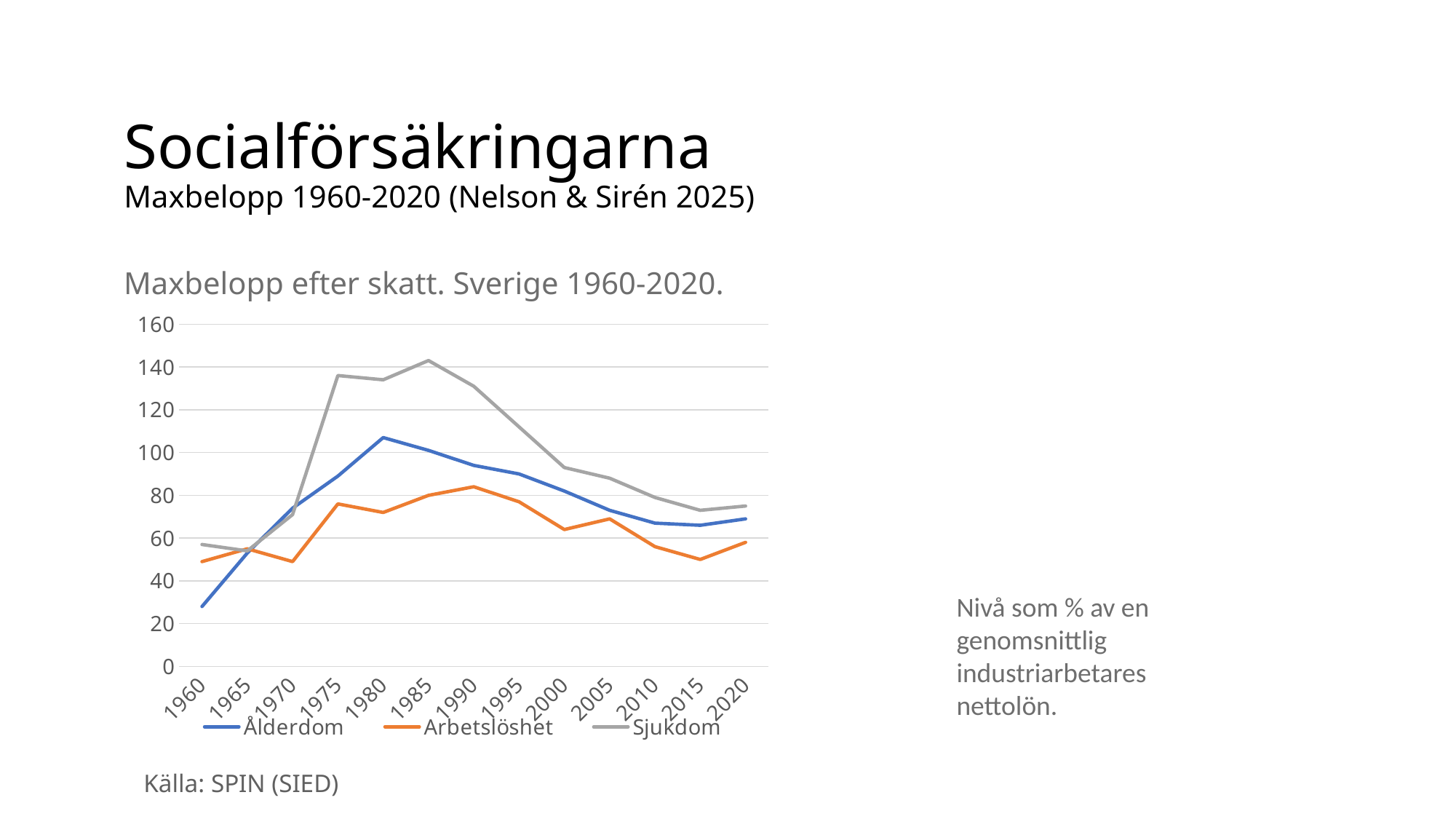
Which series reaches the highest value anywhere on the chart? Sjukdom How many years are marked along the x axis? 13 How many series does the legend list? 3 Does the Sjukdom line rise or fall between 1985 and 2015? fall Is the value for Sjukdom in 1985 greater or less than 120? greater What kind of chart is shown on the slide? line chart Is the value for Ålderdom in 1960 greater or less than 40? less In which year does the Ålderdom line reach its peak? 1980 In which year does the Sjukdom line reach its peak? 1985 Is the value for Arbetslöshet in 1990 greater or less than 60? greater In which year is the Ålderdom value lowest? 1960 In 2020, which is larger: Ålderdom or Arbetslöshet? Ålderdom